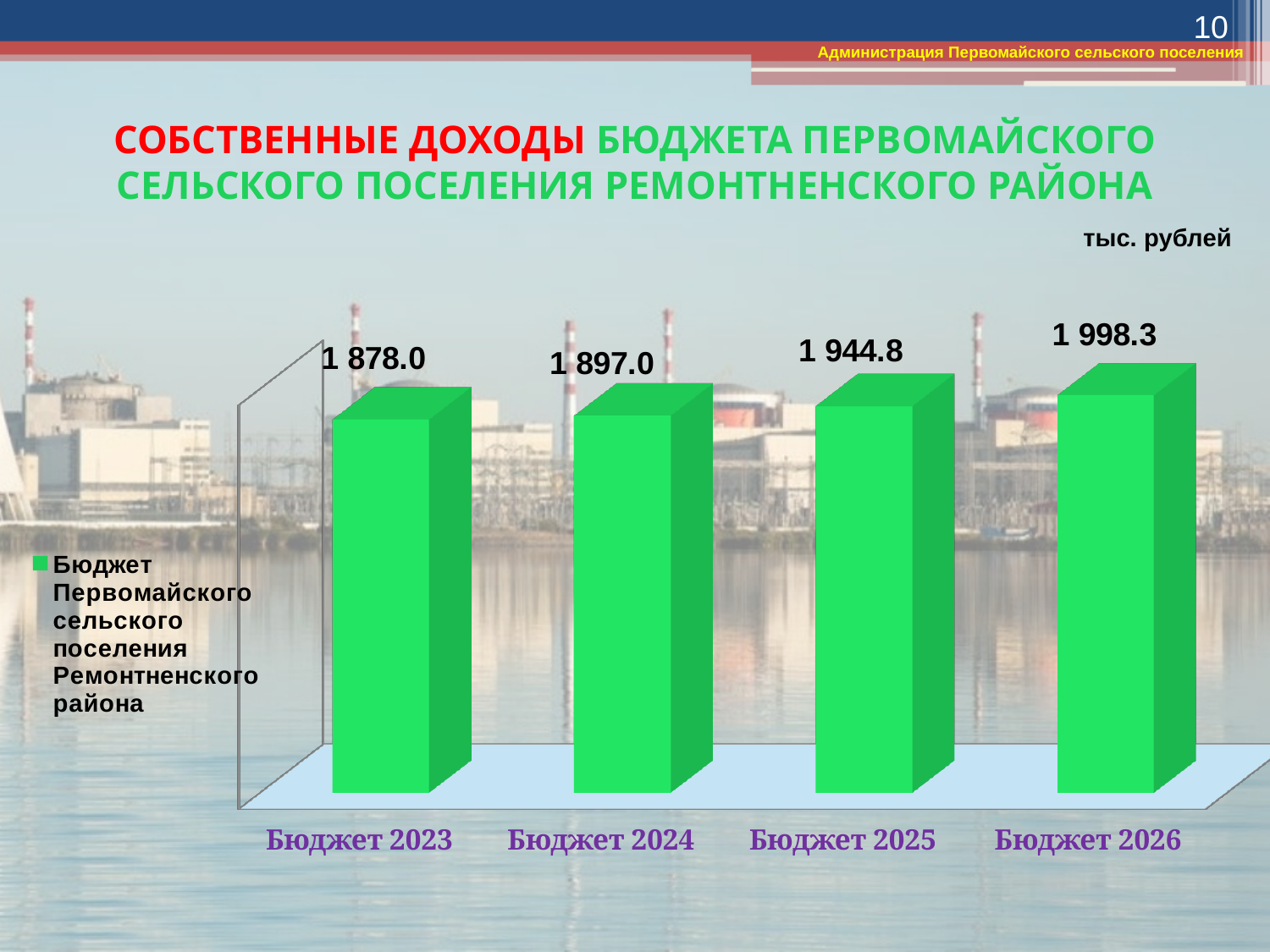
Do the values rise or fall from Бюджет 2023 to Бюджет 2026? Rise What is the value for Бюджет 2026? 1 998.3 How many series does the legend list? 1 What is the value for Бюджет 2023? 1 878.0 Which is larger, the value for Бюджет 2024 or the value for Бюджет 2025? Бюджет 2025 Which category has the lowest value? Бюджет 2023 How many categories are shown on the x axis? 4 What is the difference between the values for Бюджет 2026 and Бюджет 2023? 120.3 Which category has the highest value? Бюджет 2026 What is the value for Бюджет 2025? 1 944.8 What kind of chart is shown on the slide? Bar chart What is the difference between the values for Бюджет 2025 and Бюджет 2024? 47.8